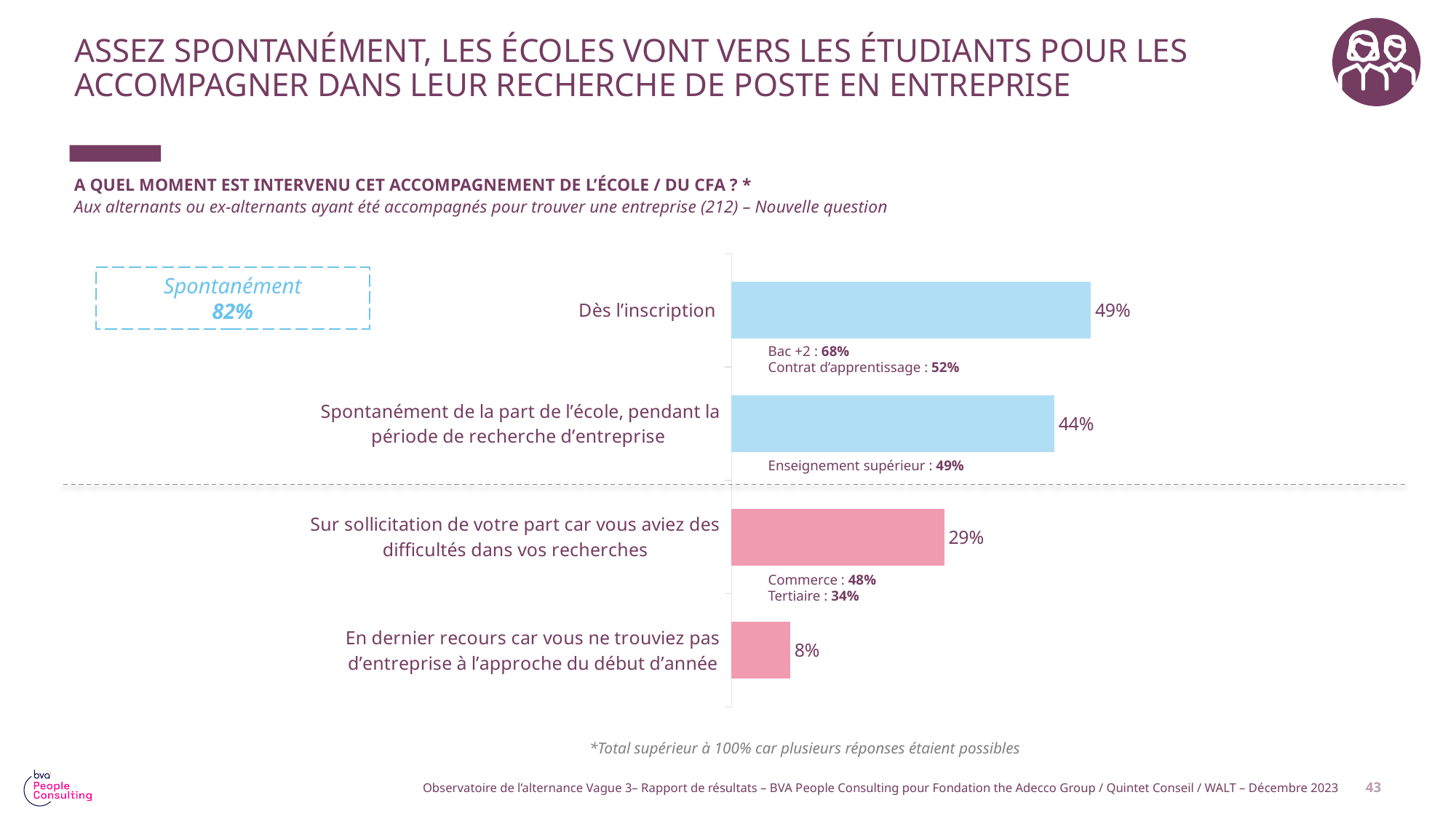
What kind of chart is shown on the slide? Bar chart What is the value for "En dernier recours car vous ne trouviez pas d'entreprise à l'approche du début d'année"? 8% Which is larger: the value for "Spontanément de la part de l'école, pendant la période de recherche d'entreprise" or the value for "En dernier recours car vous ne trouviez pas d'entreprise à l'approche du début d'année"? Spontanément de la part de l'école, pendant la période de recherche d'entreprise What is the value for "Sur sollicitation de votre part car vous aviez des difficultés dans vos recherches"? 29% What percentage is shown in the dashed box labelled "Spontanément"? 82% What is the value for "Spontanément de la part de l'école, pendant la période de recherche d'entreprise"? 44% What is the difference between the values for "Dès l'inscription" and "Sur sollicitation de votre part car vous aviez des difficultés dans vos recherches"? 20% Which category has the lowest value? En dernier recours car vous ne trouviez pas d'entreprise à l'approche du début d'année What is the value for "Dès l'inscription"? 49% What is the value for "Dès l'inscription" among Bac +2 respondents, as noted under the bar? 68% Which category has the highest value? Dès l'inscription How many categories are shown in the chart? 4